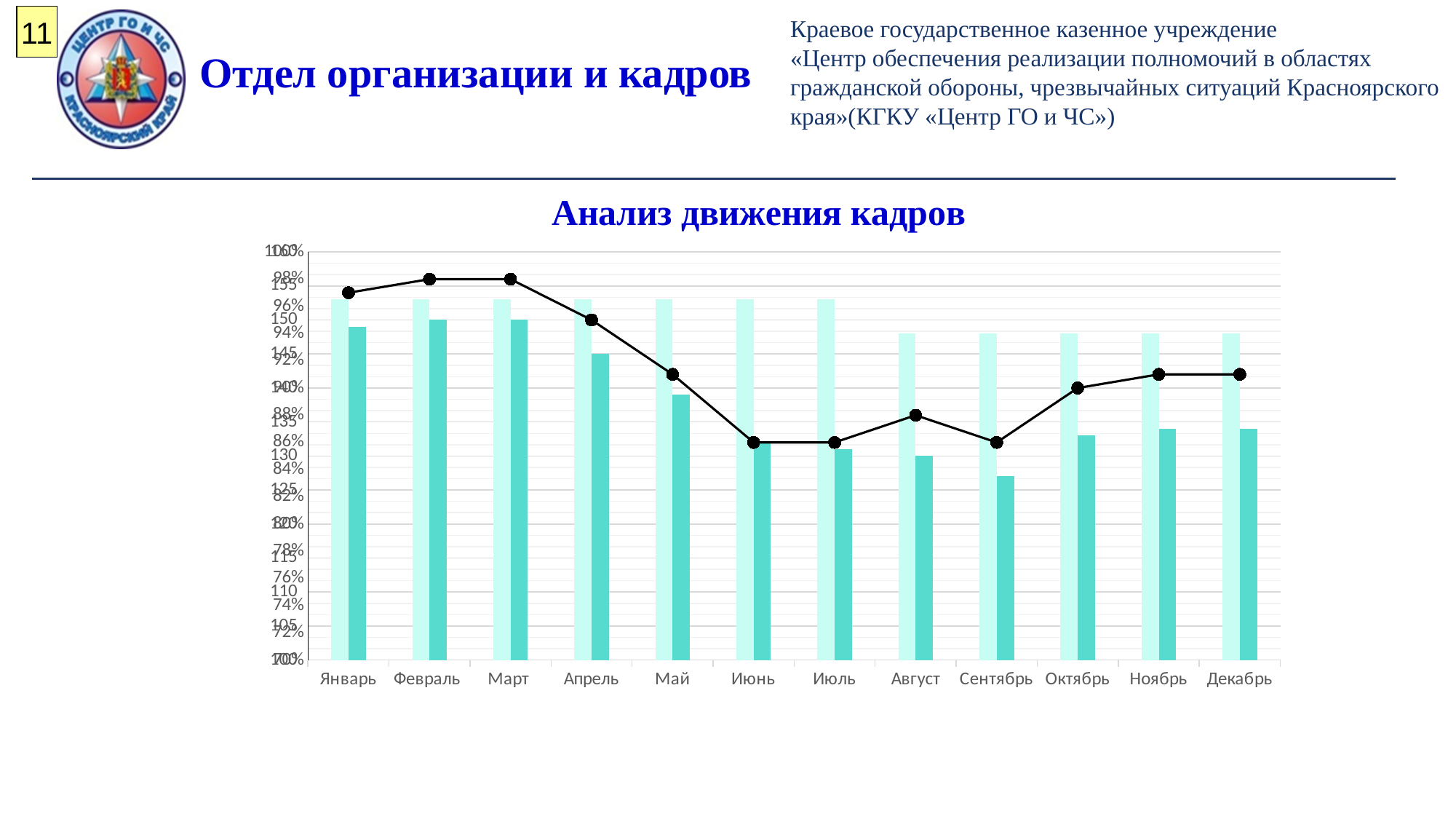
Which dark teal bar is taller, Апрель or Май? Апрель How many categories (months) are shown along the x axis of the chart? 12 What kind of chart is shown on the slide? A bar chart combined with a line What is the first category label on the x axis of the chart? Январь Does the black line rise or fall from Сентябрь to Ноябрь? Rises Which is higher on the black line, Март or Июнь? Март What is the title of the chart on the slide? Анализ движения кадров Does the black line rise or fall from Март to Июнь? Falls Which month has the lowest dark teal bar in the chart? Сентябрь Which light cyan bar is taller, Февраль or Октябрь? Февраль